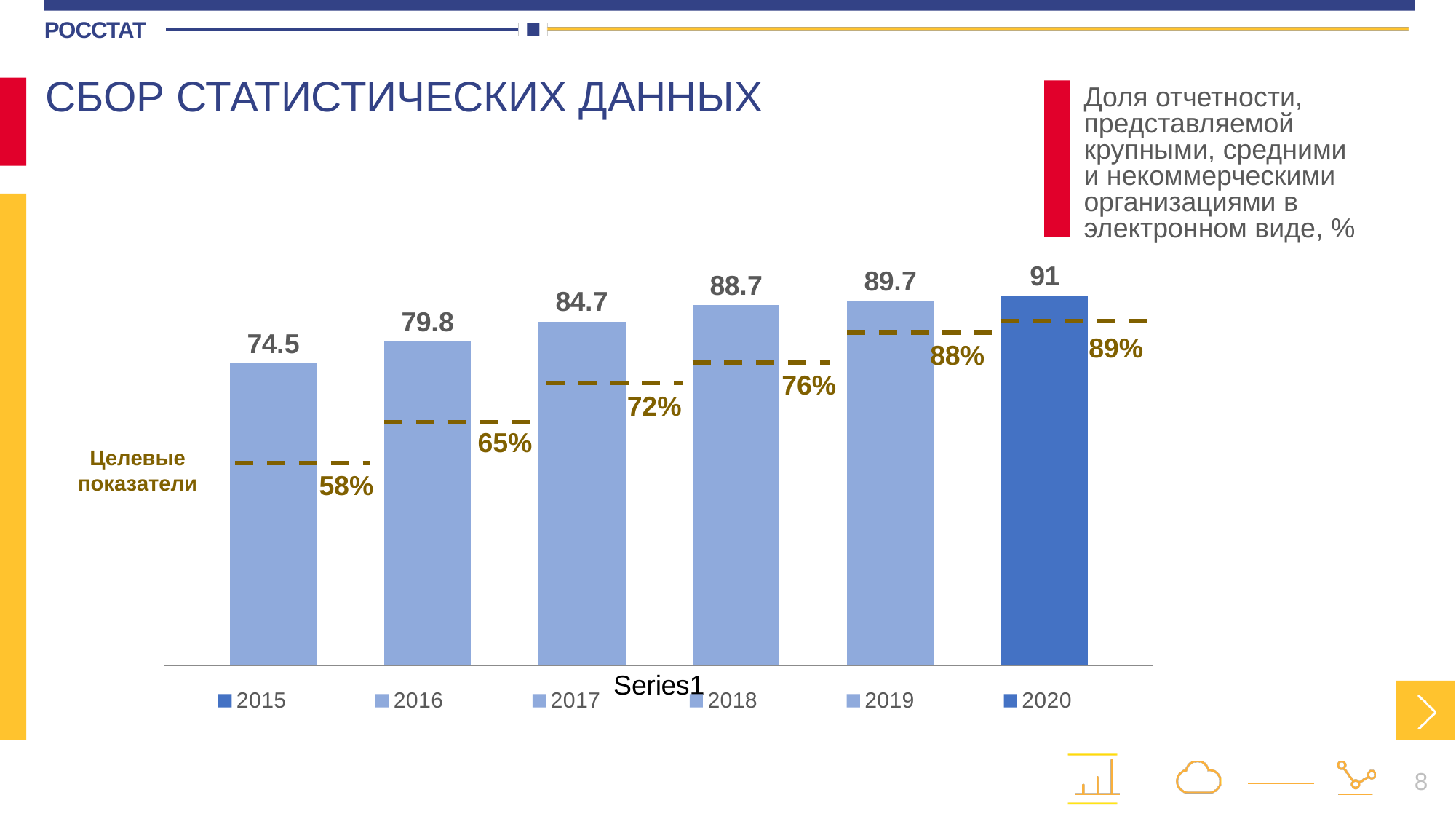
How many bars are plotted in the chart? 6 What is the value shown for 2020? 91 What is the value shown for 2015? 74.5 What kind of chart is shown on the slide? bar chart Which year has the lowest value? 2015 Do the bar values rise or fall from 2015 to 2020? rise Which is larger, the value for 2016 or the value for 2017? 2017 What is the value shown for 2018? 88.7 What is the difference between the values for 2017 and 2016? 4.9 How many entries does the legend list? 6 Which year has the highest value? 2020 What is the difference between the values for 2020 and 2015? 16.5